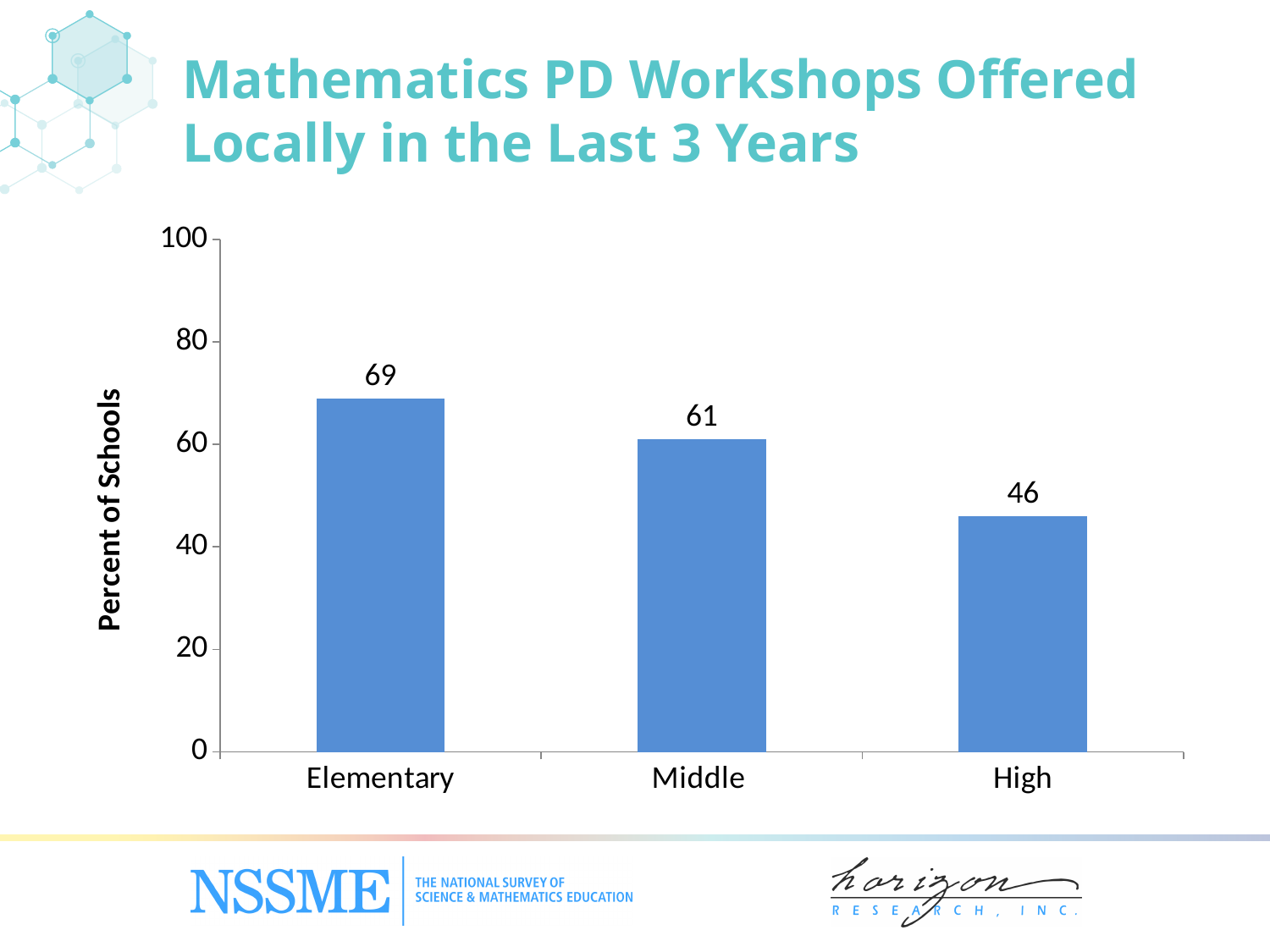
Do the values rise or fall from Elementary to High? fall What percent of elementary schools had mathematics PD workshops offered locally in the last 3 years? 69 How many school levels are shown on the chart? 3 What kind of chart is shown on the slide? bar chart What is the value for Middle schools? 61 Is the value for High schools greater or less than 60? less Which school level has the highest percent of schools? Elementary What is the difference between the values for Elementary and High schools? 23 What is the difference between the values for Elementary and Middle schools? 8 What is the value for High schools? 46 Which school level has the lowest percent of schools? High Which is larger, the value for Middle or the value for High? Middle